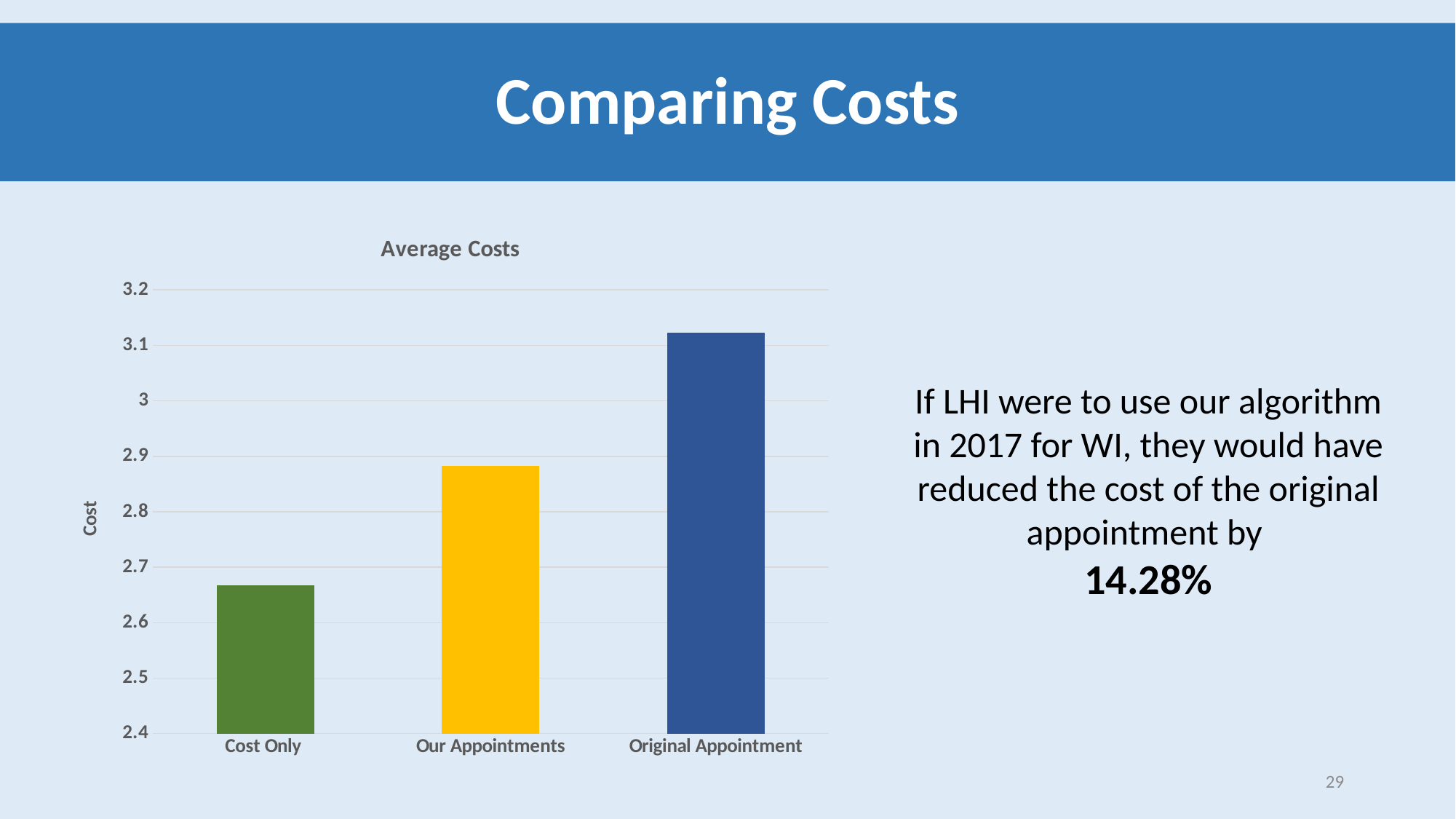
How many categories are shown on the x axis of the chart? 3 Do the bar values rise or fall from left to right along the x axis? rise Which category has the highest average cost? Original Appointment Is the value for Cost Only greater or less than 2.7? less Which category has the lowest average cost? Cost Only Which is larger, the value for Cost Only or the value for Our Appointments? Our Appointments Is the value for Original Appointment greater or less than 3.1? greater Is the value for Our Appointments greater or less than 2.8? greater Which is larger, the value for Our Appointments or the value for Original Appointment? Original Appointment What is the label on the vertical axis of the chart? Cost What kind of chart is shown on the slide? bar chart What is the title of the chart? Average Costs